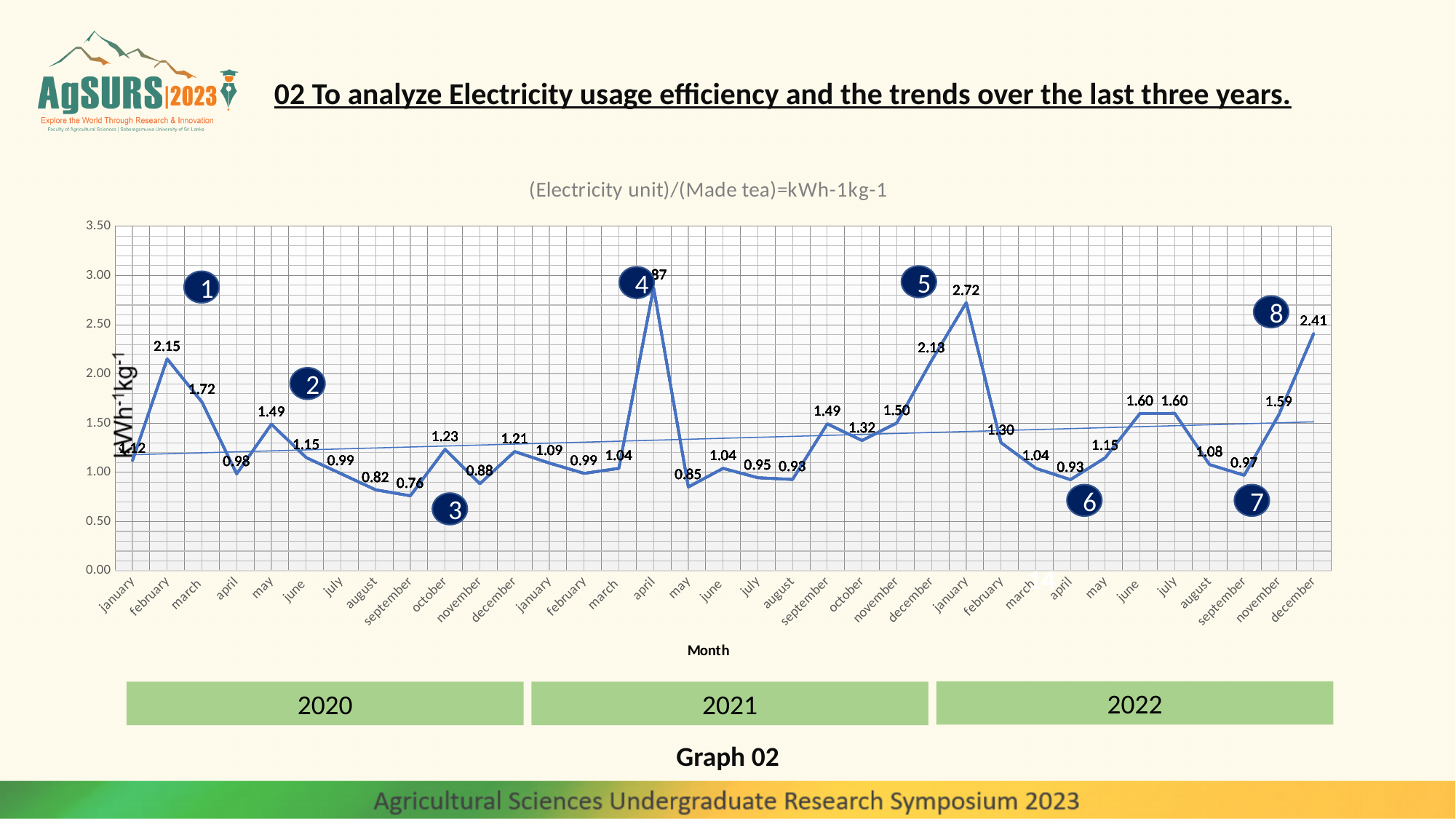
What is the difference between the values for february 2020 and march 2020? 0.43 Which month has the highest value on the chart? april 2021 What is the difference between the values for january 2022 and december 2021? 0.59 What is the label of the x axis? Month What is the value for september 2020? 0.76 Which is larger, the value for february 2020 or the value for december 2022? december 2022 What is the value for june 2022? 1.60 What is the value for january 2022? 2.72 What is the value for february 2020? 2.15 Is the value for december 2021 greater or less than 2.00? greater What is the value for december 2022? 2.41 What kind of chart is shown on the slide? line chart